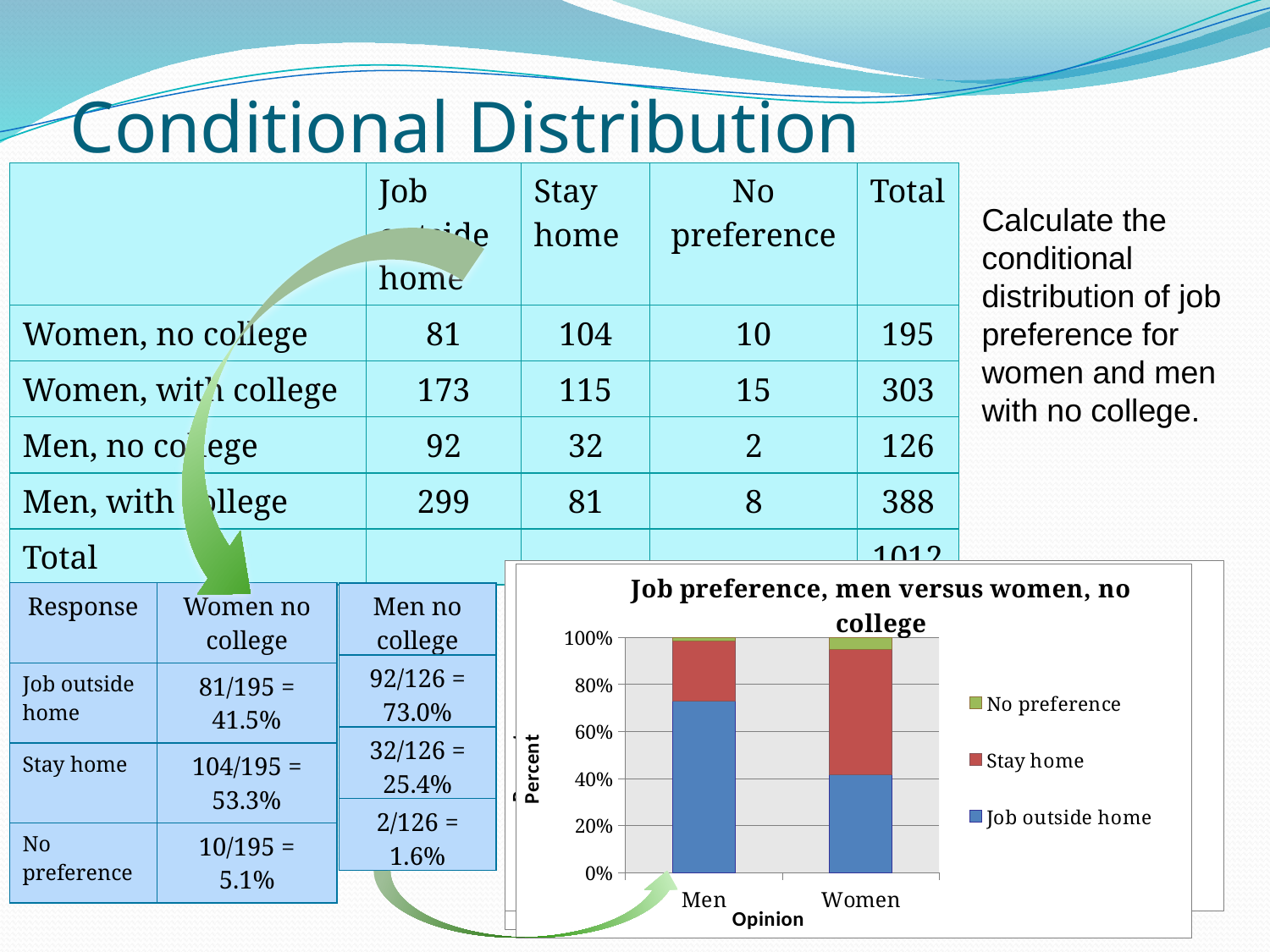
Is the Job outside home share for Women greater or less than 60%? less How many categories are shown on the x axis of the chart? 2 How many series does the chart legend list? 3 Which category has the larger Stay home share, Men or Women? Women Is the Job outside home share for Men greater or less than 60%? greater Which category has the smallest No preference share? Men What is the title of the chart? Job preference, men versus women, no college Which series is shown at the bottom of each stacked bar? Job outside home Is the Job outside home share for Women greater or less than 20%? greater Which category has the larger Job outside home share, Men or Women? Men What kind of chart is shown on the slide? Stacked bar chart